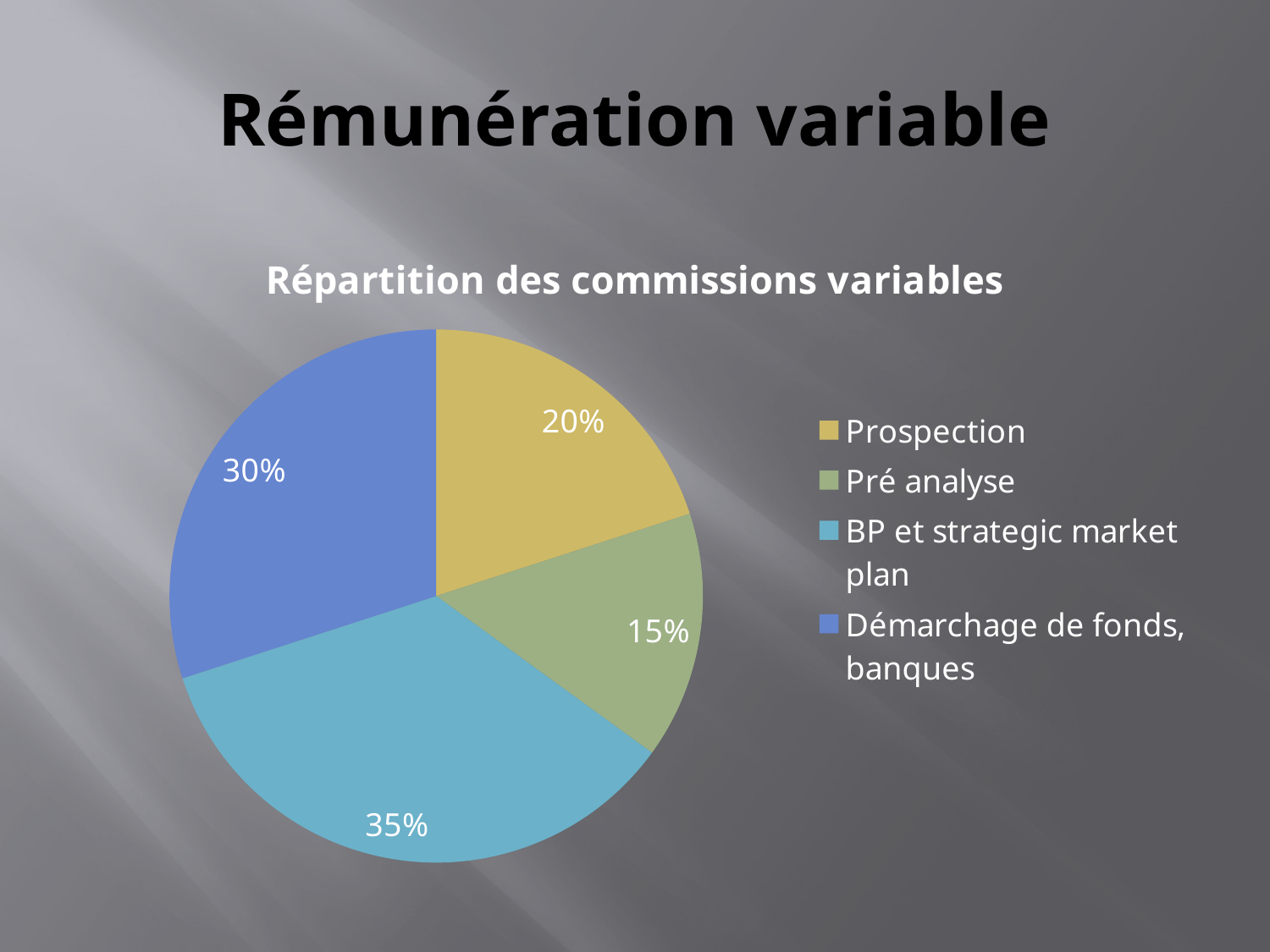
What share of the pie does Prospection represent? 20% What share of the pie does Pré analyse represent? 15% What is the title of the chart? Répartition des commissions variables Which category has the largest slice of the pie? BP et strategic market plan How many categories does the pie chart have? 4 What share of the pie does Démarchage de fonds, banques represent? 30% How many entries does the legend list? 4 What is the difference between the shares of BP et strategic market plan and Prospection? 15% Which is larger, the share for Démarchage de fonds, banques or the share for Prospection? Démarchage de fonds, banques Which category has the smallest slice of the pie? Pré analyse What type of chart is shown on the slide? pie chart What share of the pie does BP et strategic market plan represent? 35%